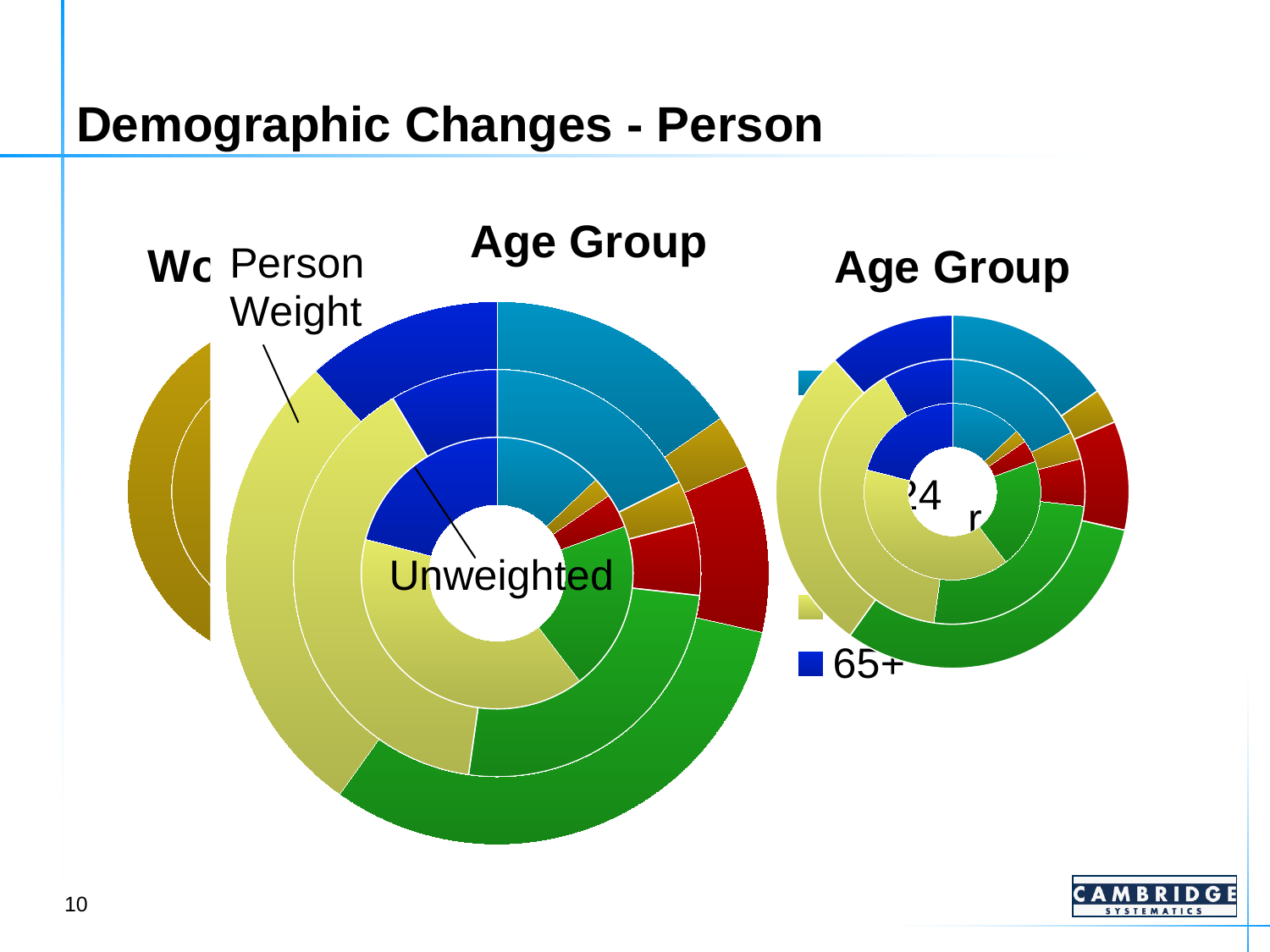
In the outer ring of the large "Age Group" chart, which colour segment is the smallest? Gold In the outer ring of the large "Age Group" chart, which colour segment is the largest? Green In the outer ring of the large "Age Group" chart, which is larger: the green segment or the light blue segment? Green In the outer ring of the large "Age Group" chart, which is larger: the yellow segment or the red segment? Yellow How many concentric rings does the large "Age Group" chart have? 3 How many concentric rings does the smaller "Age Group" chart on the right have? 3 In the outer ring of the smaller "Age Group" chart on the right, which colour segment is the largest? Green What colour represents the "65+" age group in the legend? Blue How many segments does the outer ring of the large "Age Group" chart contain? 6 What is the title of the large chart in the centre of the slide? Age Group What kind of chart is the large chart titled "Age Group"? Doughnut chart